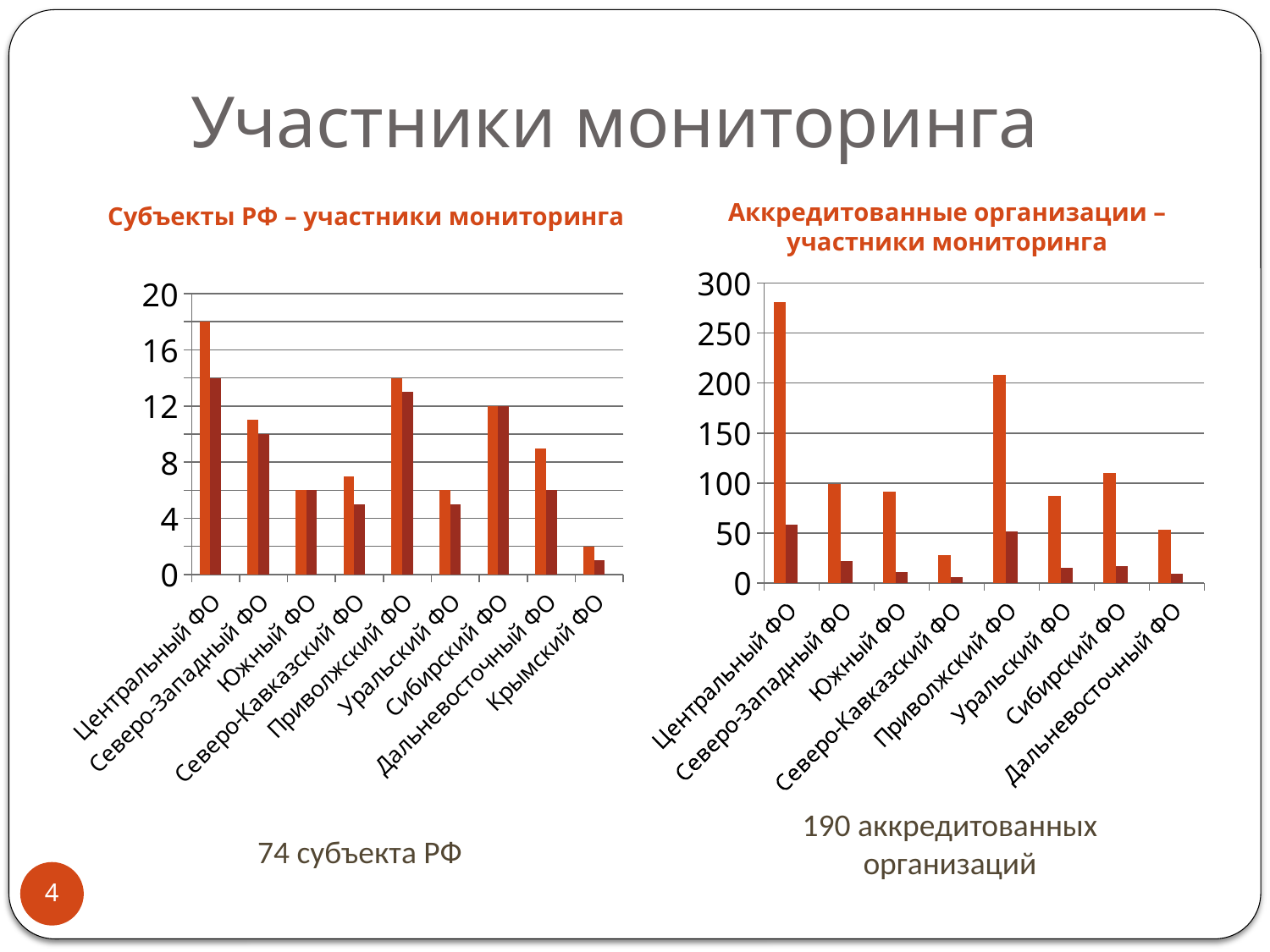
How many federal districts (categories) are shown on the left chart, 'Субъекты РФ – участники мониторинга'? 9 On the left chart, 'Субъекты РФ – участники мониторинга', which federal district has the tallest bar? Центральный ФО On the right chart, 'Аккредитованные организации – участники мониторинга', is the first bar for Центральный ФО greater or less than 250? greater What kind of chart is the left chart, 'Субъекты РФ – участники мониторинга'? bar chart How many federal districts (categories) are shown on the right chart, 'Аккредитованные организации – участники мониторинга'? 8 On the right chart, 'Аккредитованные организации – участники мониторинга', which federal district has the lowest first bar? Северо-Кавказский ФО On the right chart, 'Аккредитованные организации – участники мониторинга', which has the taller first bar: Сибирский ФО or Уральский ФО? Сибирский ФО On the left chart, 'Субъекты РФ – участники мониторинга', is the first bar for Крымский ФО greater or less than 4? less On the left chart, 'Субъекты РФ – участники мониторинга', which federal district has the lowest bars? Крымский ФО On the right chart, 'Аккредитованные организации – участники мониторинга', is the first bar for Северо-Кавказский ФО greater or less than 50? less On the right chart, 'Аккредитованные организации – участники мониторинга', which federal district has the tallest bar? Центральный ФО